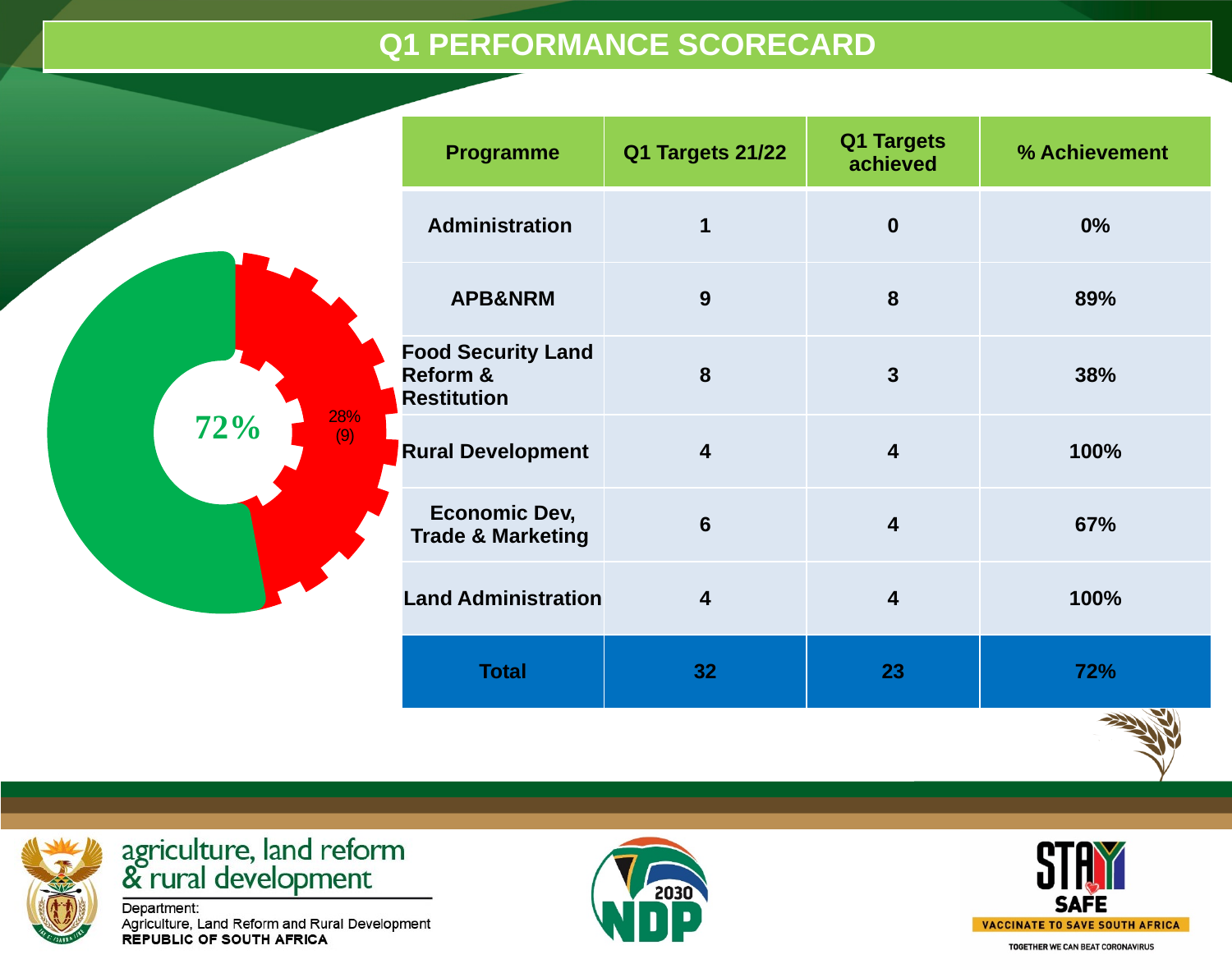
What is the difference in percentage points between the green slice (72%) and the red slice (28%)? 44 percentage points What value is printed in the centre of the doughnut chart? 72% Which slice of the doughnut chart is the largest? the green slice (72%) Which slice of the doughnut chart is the smallest? the red slice (28%) What share of the doughnut chart does the red slice represent? 28% What percentage is shown for the green slice of the doughnut chart? 72% What two colours are used for the slices of the doughnut chart? green and red How many slices does the doughnut chart have? 2 Is the green slice or the red slice of the doughnut chart larger? the green slice What count is shown in brackets next to the 28% label on the red slice? 9 What percentage is shown for the red slice of the doughnut chart? 28% What kind of chart is shown on the left of the slide? doughnut (pie) chart